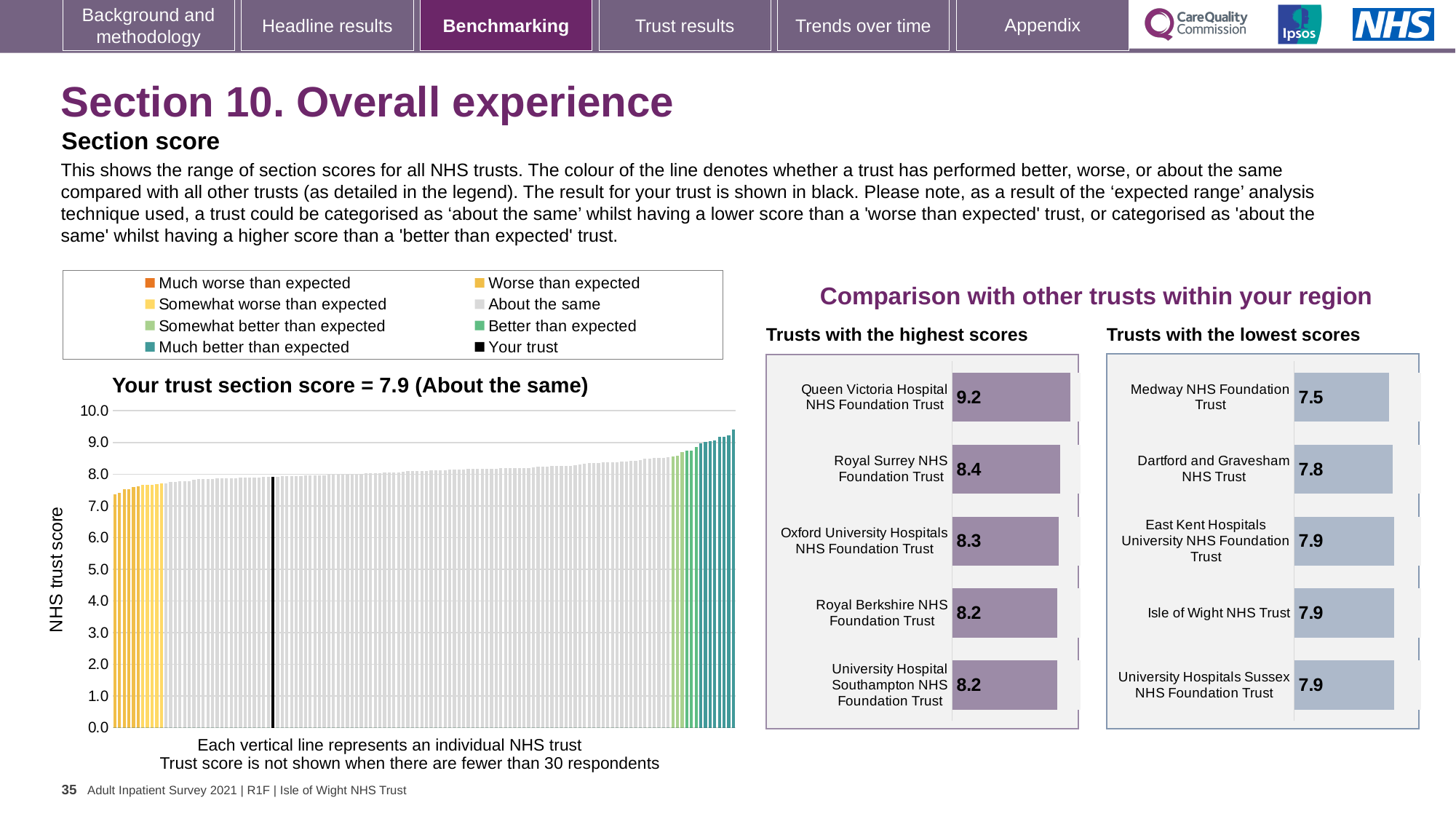
On the 'Your trust section score' chart, what is the section score for your trust? 7.9 On the 'Your trust section score' chart, is the highest trust score greater or less than 9.0? greater On the 'Trusts with the lowest scores' chart, which trust has the lowest score? Medway NHS Foundation Trust On the 'Your trust section score' chart, is the lowest trust score greater or less than 7.0? greater What kind of chart is the 'Your trust section score' chart? bar chart On the 'Trusts with the highest scores' chart, which has the higher score: Royal Surrey NHS Foundation Trust or Oxford University Hospitals NHS Foundation Trust? Royal Surrey NHS Foundation Trust On the 'Trusts with the highest scores' chart, what is the difference between the scores of Queen Victoria Hospital NHS Foundation Trust and Royal Surrey NHS Foundation Trust? 0.8 How many trusts are shown on the 'Trusts with the lowest scores' chart? 5 On the 'Trusts with the highest scores' chart, what is the score for Queen Victoria Hospital NHS Foundation Trust? 9.2 On the 'Your trust section score' chart, which category is your trust placed in? About the same On the 'Trusts with the lowest scores' chart, what is the score for Dartford and Gravesham NHS Trust? 7.8 How many entries does the legend above the 'Your trust section score' chart list? 8